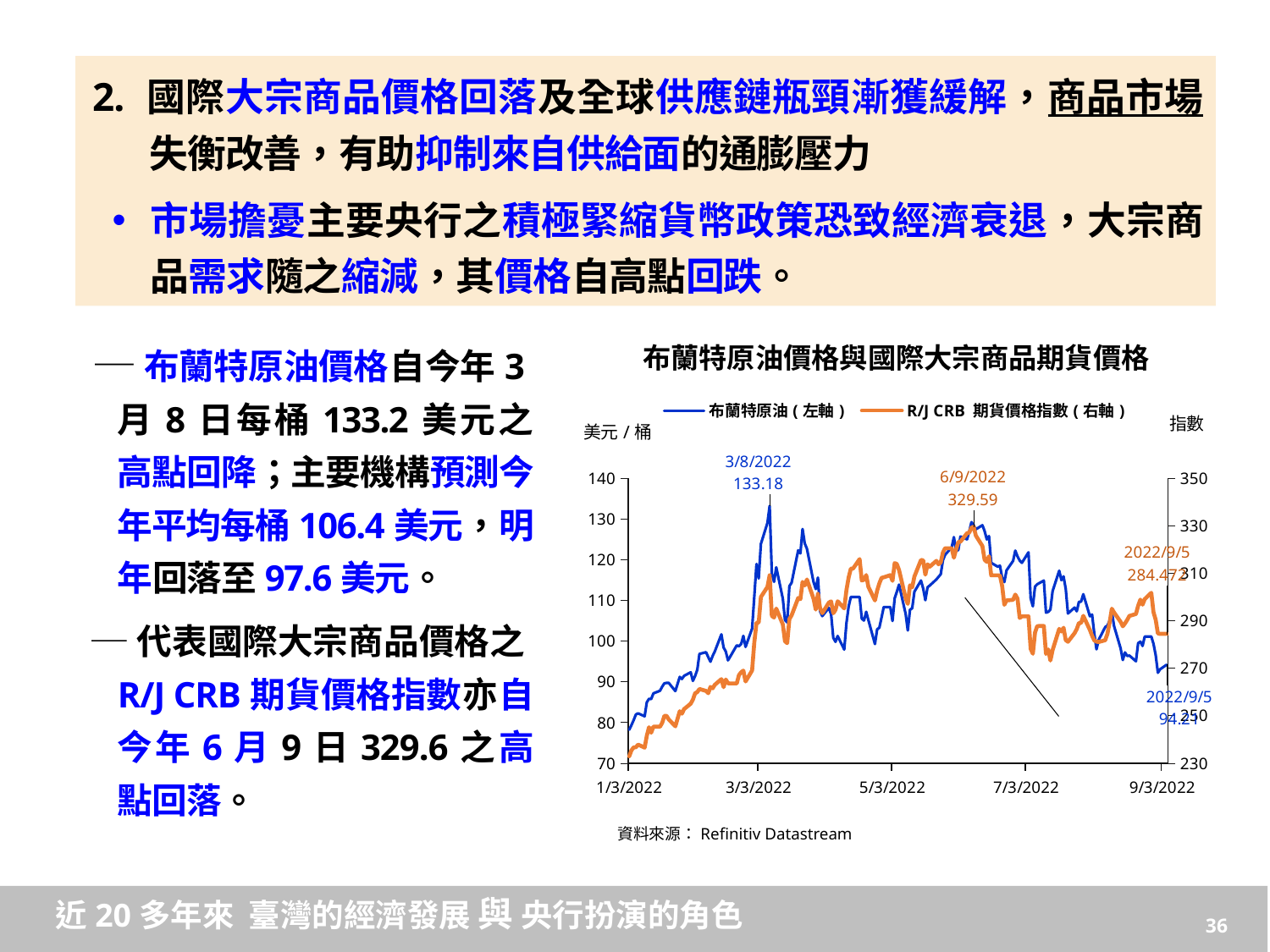
Is the value of the R/J CRB 期貨價格指數 at 9/3/2022 greater or less than 310? less Is the value of 布蘭特原油 at 1/3/2022 greater or less than 90? less On what date does the chart label the peak of the R/J CRB 期貨價格指數? 6/9/2022 Does the 布蘭特原油 line rise or fall between 1/3/2022 and 3/8/2022? rise What is the labelled peak value of 布蘭特原油 on 3/8/2022? 133.18 What is the title of the chart? 布蘭特原油價格與國際大宗商品期貨價格 What is the labelled peak value of the R/J CRB 期貨價格指數 on 6/9/2022? 329.59 Which series reaches its labelled peak earlier, 布蘭特原油 or the R/J CRB 期貨價格指數? 布蘭特原油 How many series does the chart legend list? 2 What kind of chart is shown on the slide? line chart What is the data source given below the chart? Refinitiv Datastream On what date does the chart label the peak of 布蘭特原油? 3/8/2022